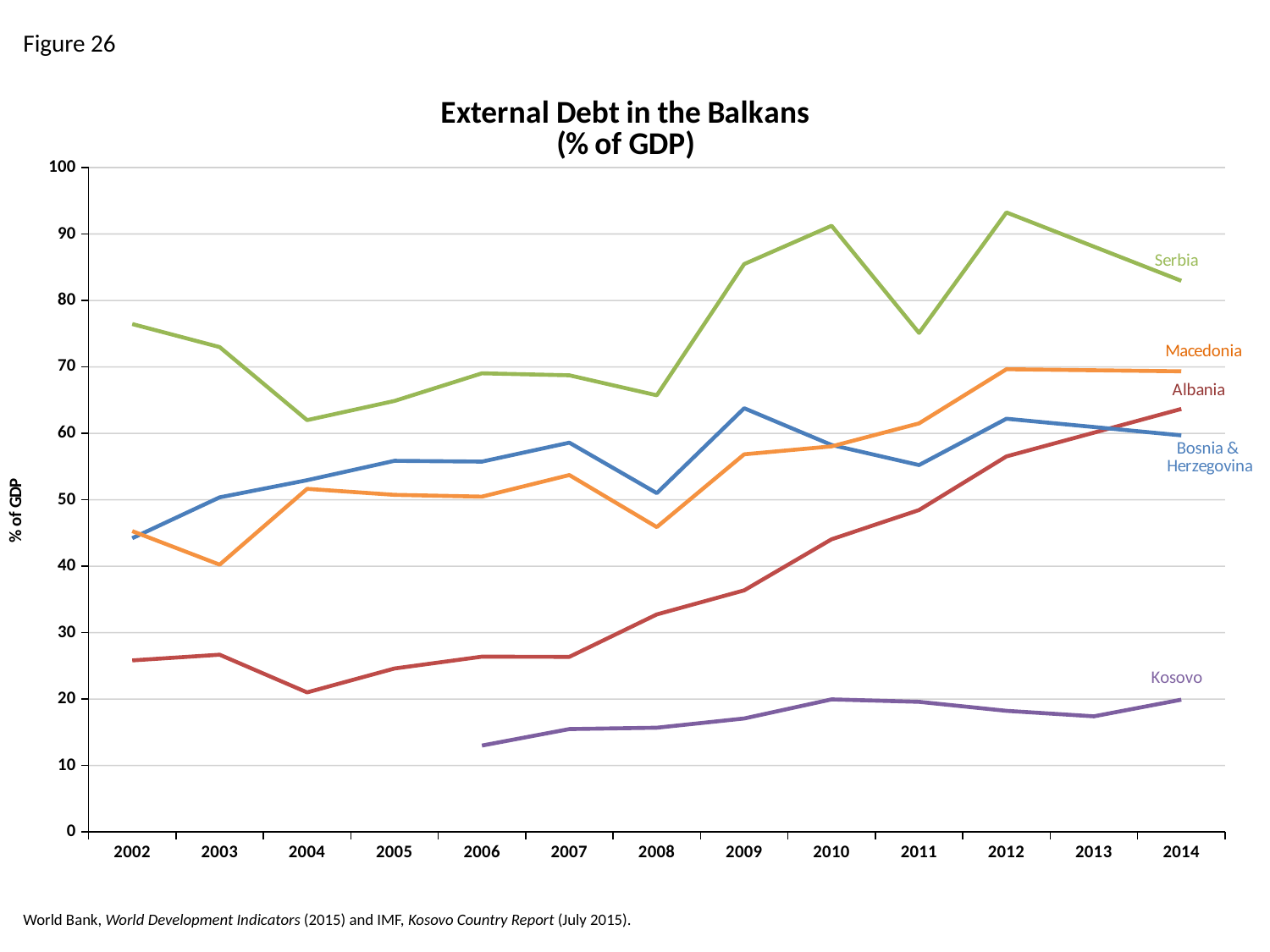
Does Albania's external debt rise or fall from 2004 to 2014? rise Which country has the highest external debt as % of GDP in 2014? Serbia How many countries (series) are plotted in the chart? 5 Is the value for Kosovo in 2006 greater or less than 20? less Is the value for Serbia in 2012 greater or less than 90? greater How many years are shown on the x axis of the chart? 13 What is the label on the y axis of the chart? % of GDP Is the value for Bosnia & Herzegovina in 2009 greater or less than 60? greater Which country has the lowest external debt as % of GDP in 2014? Kosovo What kind of chart is shown on the slide? line chart In 2011, which country has the higher external debt: Serbia or Macedonia? Serbia